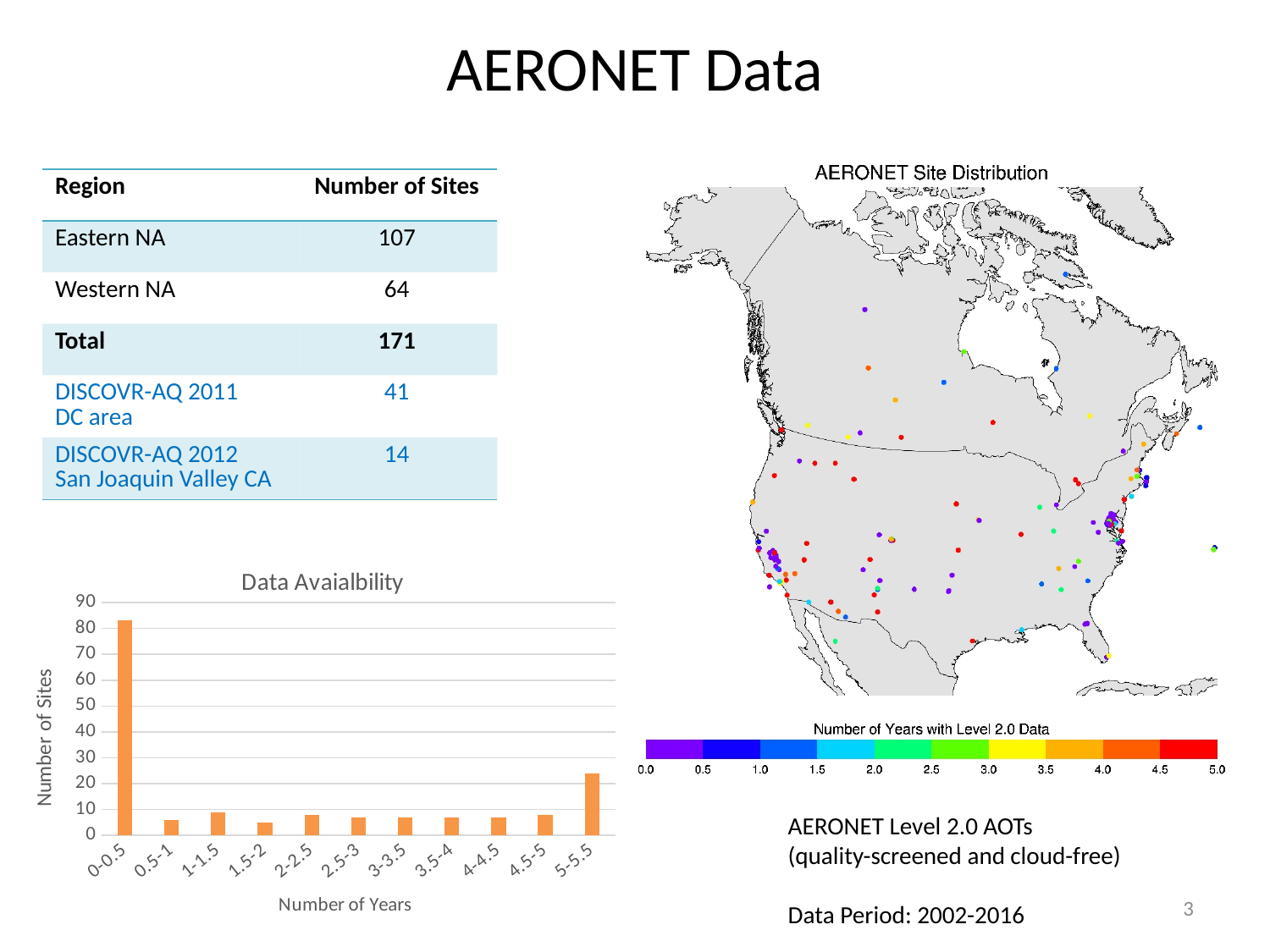
What is the x-axis label of the "Data Avaialbility" chart? Number of Years In the "Data Avaialbility" chart, is the number of sites for 5-5.5 years greater or less than 20? greater In the "Data Avaialbility" chart, is the number of sites for 1-1.5 years greater or less than 20? less In the "Data Avaialbility" chart, which has more sites: 5-5.5 years or 2.5-3 years? 5-5.5 In the "Data Avaialbility" chart, which category has the second-highest number of sites? 5-5.5 In the "Data Avaialbility" chart, is the number of sites for 5-5.5 years greater or less than 30? less What kind of chart is the "Data Avaialbility" chart? bar chart In the "Data Avaialbility" chart, which number-of-years category has the highest number of sites? 0-0.5 What is the y-axis label of the "Data Avaialbility" chart? Number of Sites In the "Data Avaialbility" chart, which has more sites: 0-0.5 years or 5-5.5 years? 0-0.5 How many categories are shown on the x axis of the "Data Avaialbility" chart? 11